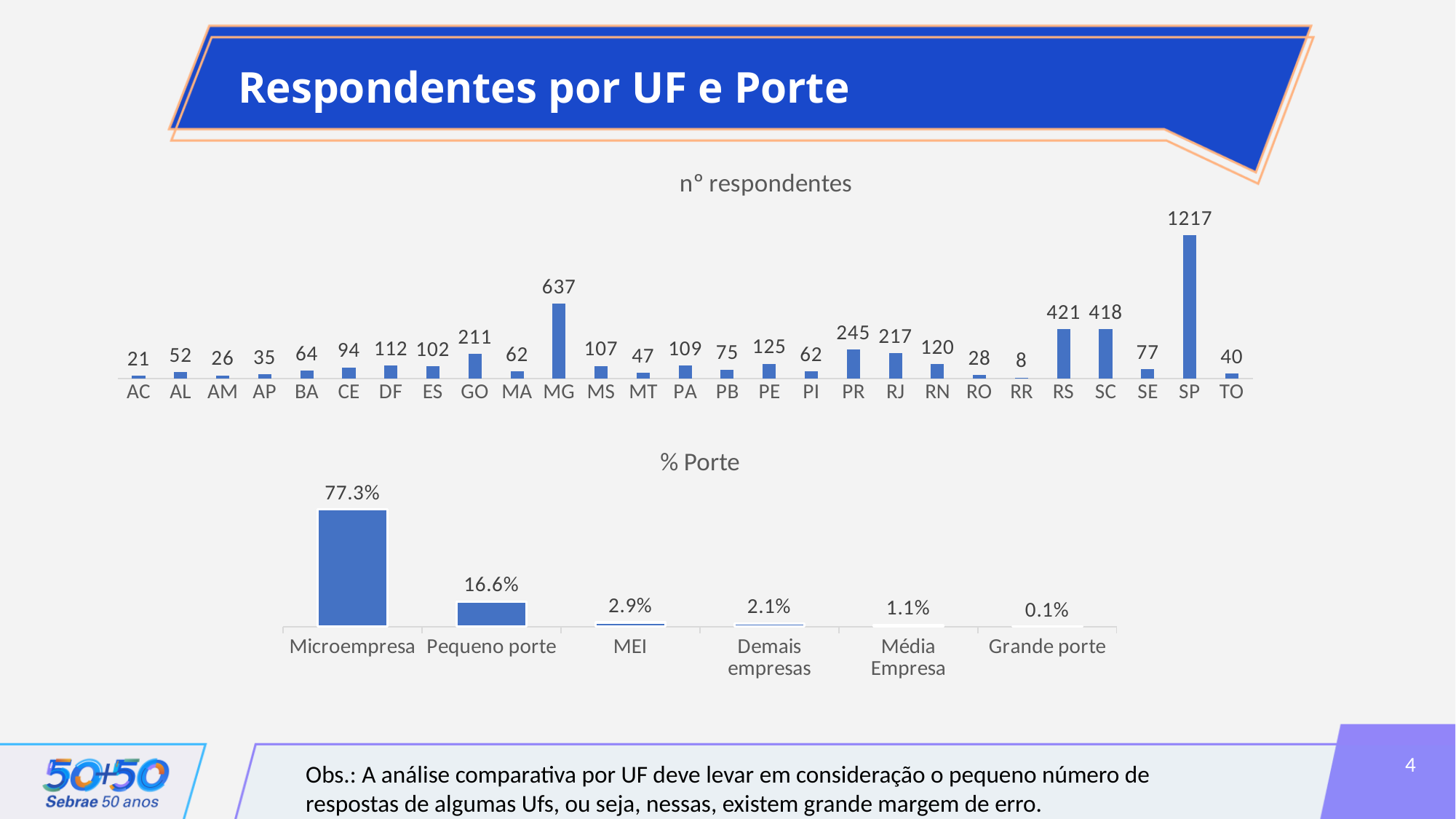
In the 'nº respondentes' chart, what is the value for SP? 1217 In the 'nº respondentes' chart, which UF has the lowest number of respondents? RR In the '% Porte' chart, what is the difference between Microempresa and Pequeno porte? 60.7% In the 'nº respondentes' chart, which UF has the highest number of respondents? SP What type of chart is the '% Porte' chart? Bar chart In the 'nº respondentes' chart, which is larger, the value for PR or the value for RJ? PR In the '% Porte' chart, what is the share for Microempresa? 77.3% In the 'nº respondentes' chart, what is the difference between the values for RS and SC? 3 In the '% Porte' chart, which category has the lowest share? Grande porte How many UF categories are shown in the 'nº respondentes' chart? 27 In the '% Porte' chart, what is the value for Pequeno porte? 16.6% In the 'nº respondentes' chart, what is the value for MG? 637